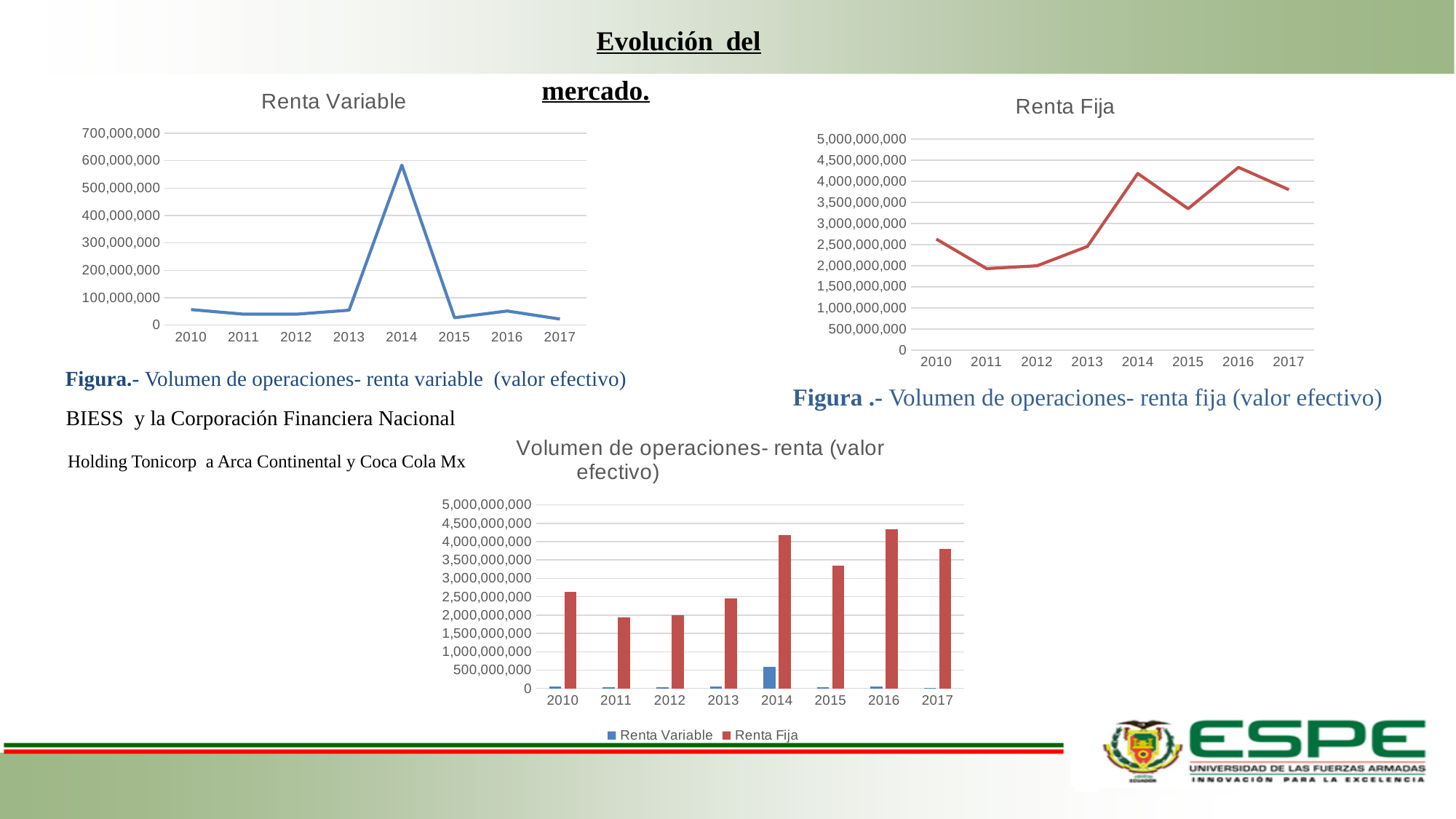
In the bottom chart "Volumen de operaciones- renta (valor efectivo)", which is larger in 2014, Renta Variable or Renta Fija? Renta Fija In the "Renta Fija" chart, is the value for 2015 greater or less than 3,500,000,000? less In the "Renta Variable" chart, is the value for 2010 greater or less than 100,000,000? less How many years are plotted on the x axis of the "Renta Fija" chart? 8 In the "Renta Fija" chart, do the values rise or fall from 2011 to 2014? rise In the "Renta Variable" chart, is the value for 2014 greater or less than 500,000,000? greater How many series does the legend of the bottom chart "Volumen de operaciones- renta (valor efectivo)" list? 2 What kind of chart is the "Renta Variable" chart? line chart What kind of chart is the bottom chart "Volumen de operaciones- renta (valor efectivo)"? bar chart In the "Renta Fija" chart, which year has the highest value? 2016 In the "Renta Variable" chart, which year has the highest value? 2014